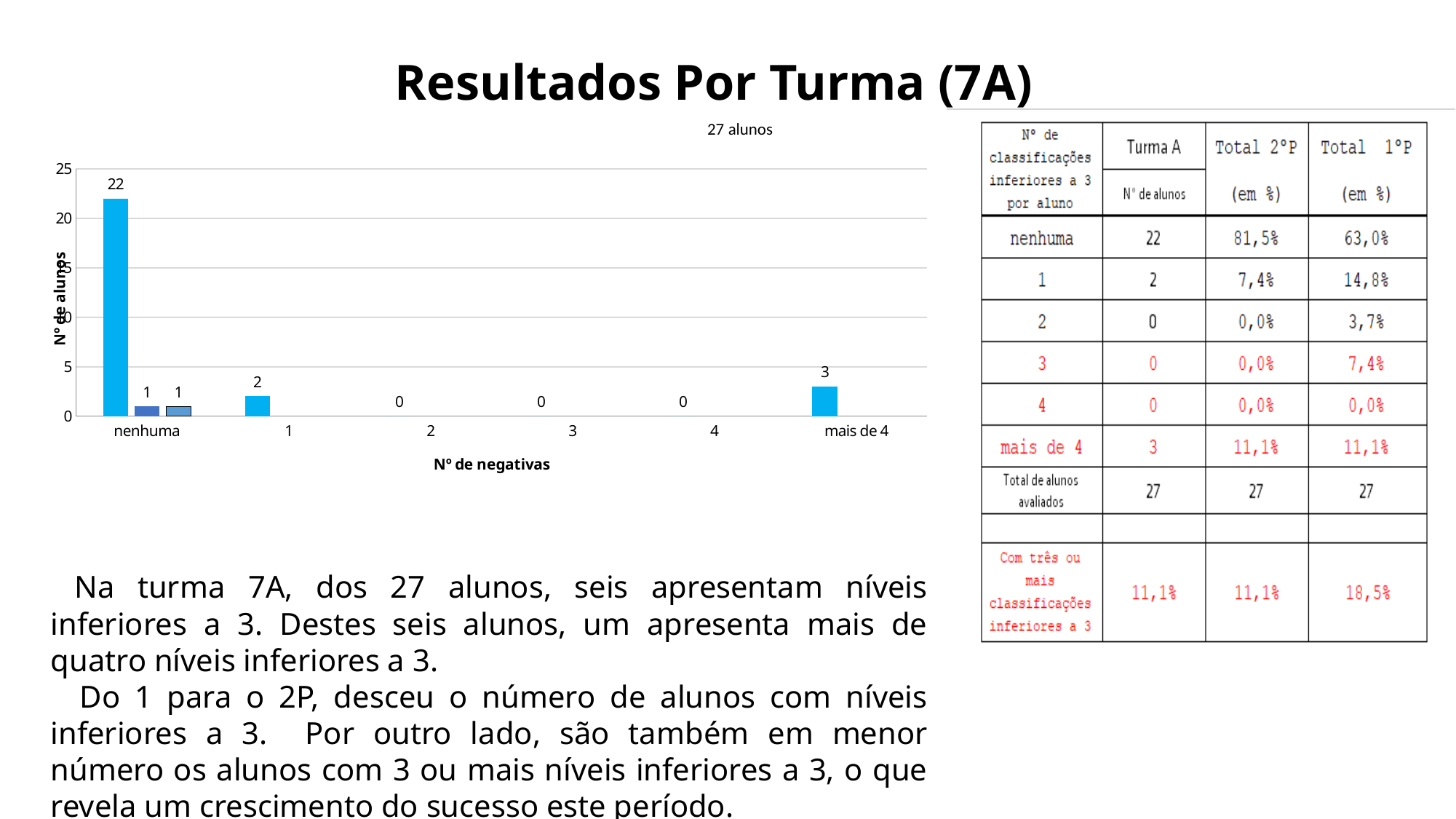
How many categories on the x axis have a value of 0? 3 Which is larger: the value for '1' or the value for 'mais de 4'? mais de 4 How many categories are shown on the x axis of the chart? 6 What is the value for the category '1' on the Nº de negativas axis? 2 What is the difference between the value for 'nenhuma' and the value for 'mais de 4'? 19 Is the value for 'nenhuma' greater or less than 20? greater How many students (Nº de alunos) are shown for the category 'nenhuma'? 22 What is the value for the category '2'? 0 What kind of chart is shown on the slide? bar chart What is the title of the x axis of the chart? Nº de negativas Which category has the highest number of students? nenhuma What is the value for the category 'mais de 4'? 3